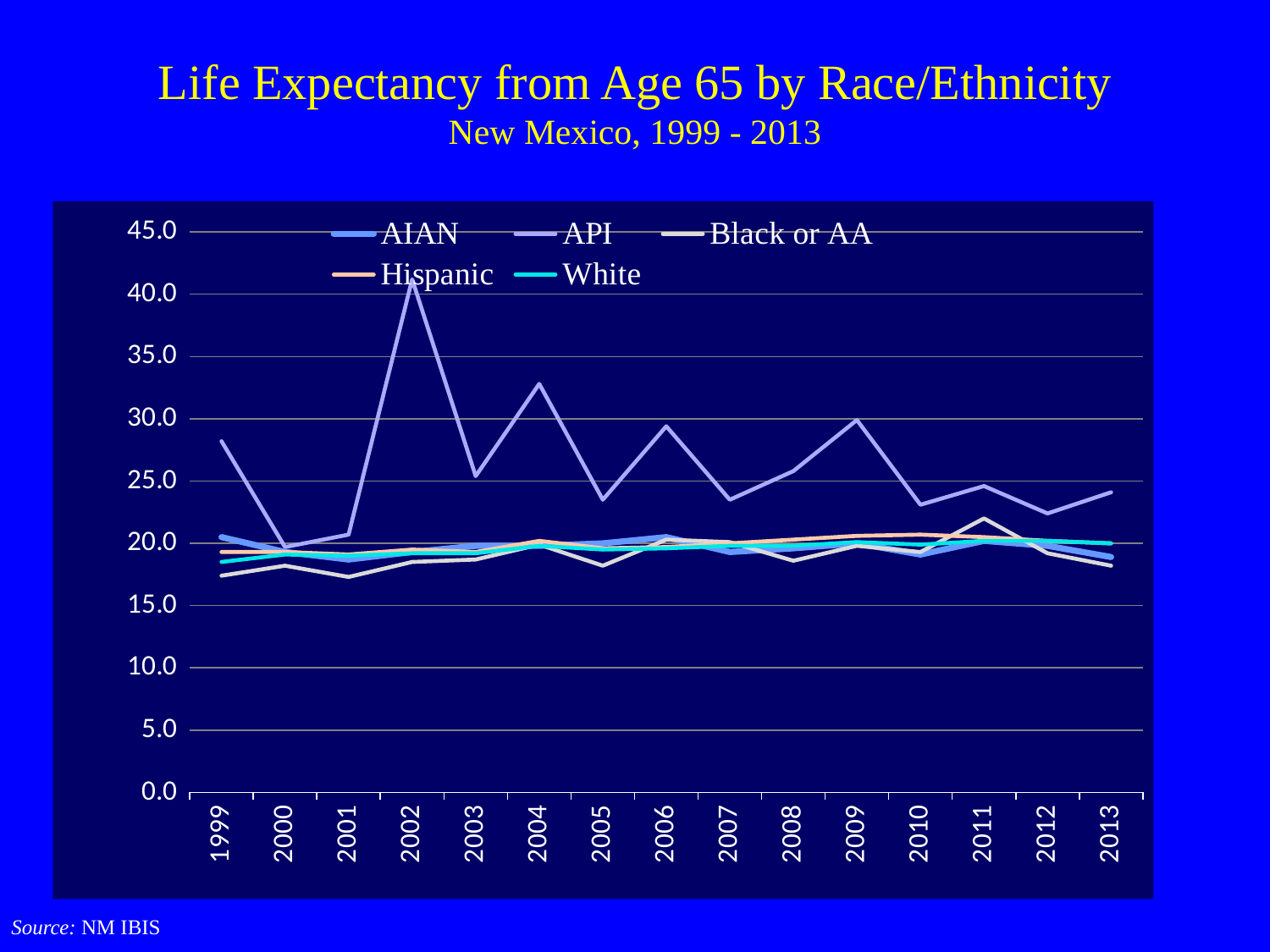
How many years are plotted along the x axis? 15 Is the API value in 2002 greater or less than 35.0? greater Does the API series rise or fall from 2009 to 2010? fall Is the Black or AA value in 1999 greater or less than 20.0? less Which series has the lowest value in 1999? Black or AA What kind of chart is shown on the slide? line chart Which is larger in 2009, the API value or the White value? API Which series has the highest value in 2002? API How many series does the legend list? 5 In which year does the API series reach its highest value? 2002 What source is cited for the chart? NM IBIS Is the API value in 1999 greater or less than 25.0? greater